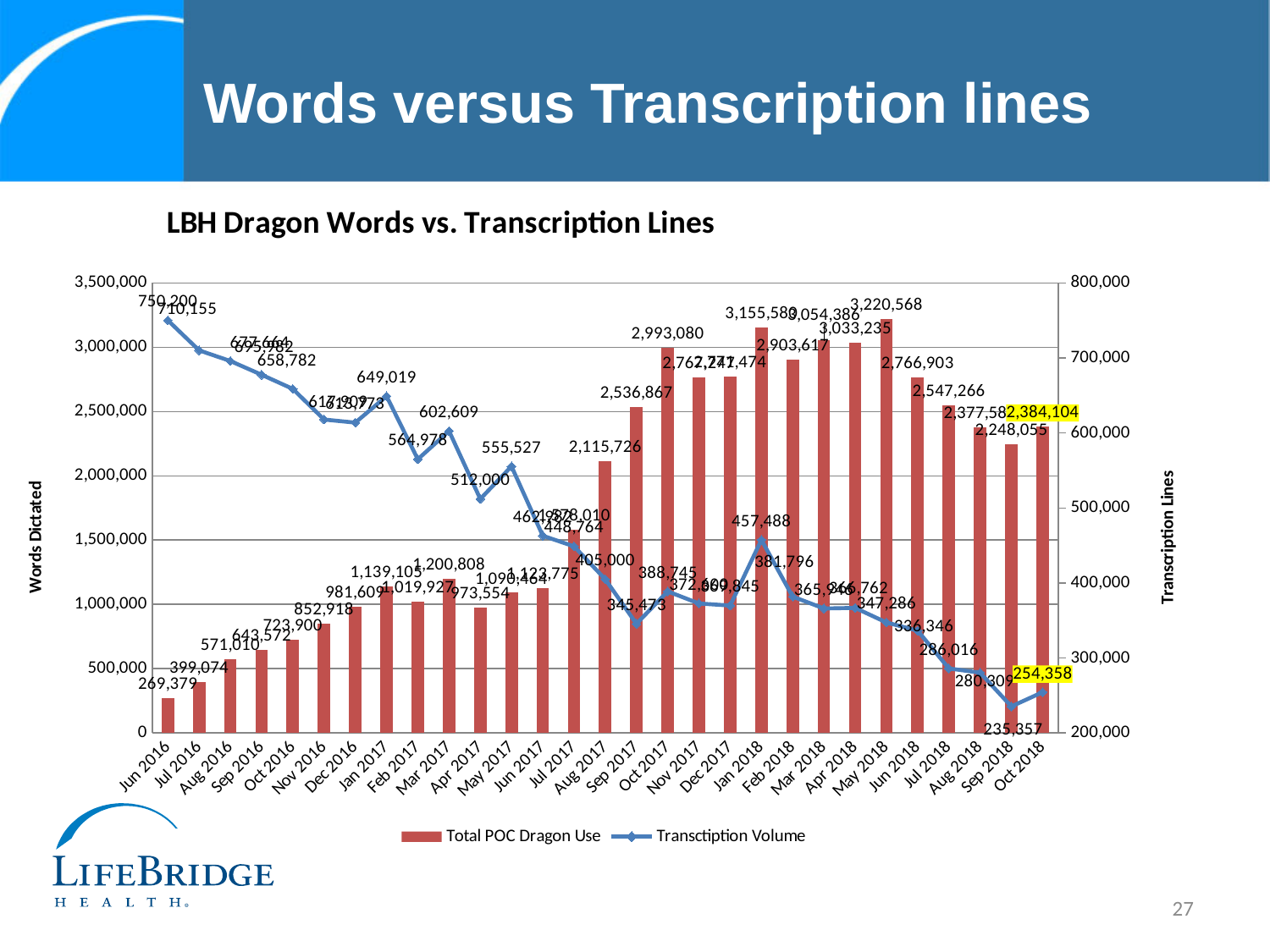
What is the Total POC Dragon Use value for May 2018? 3,220,568 What is the title of the chart? LBH Dragon Words vs. Transcription Lines How many months are plotted along the x axis? 29 How many series does the legend list? 2 Which month has the highest Total POC Dragon Use? May 2018 What kind of chart is shown? Combination bar and line chart Does the Transcription Volume generally rise or fall from Jun 2016 to Oct 2018? Fall Is the Transcription Volume for Jun 2016 greater or less than 700,000? greater Which is larger, the Total POC Dragon Use in Oct 2017 or in Jan 2018? Jan 2018 What is the difference in Total POC Dragon Use between Oct 2018 and Sep 2018? 136,049 Which month has the lowest Transcription Volume? Sep 2018 What is the Transcription Volume value for Oct 2018? 254,358